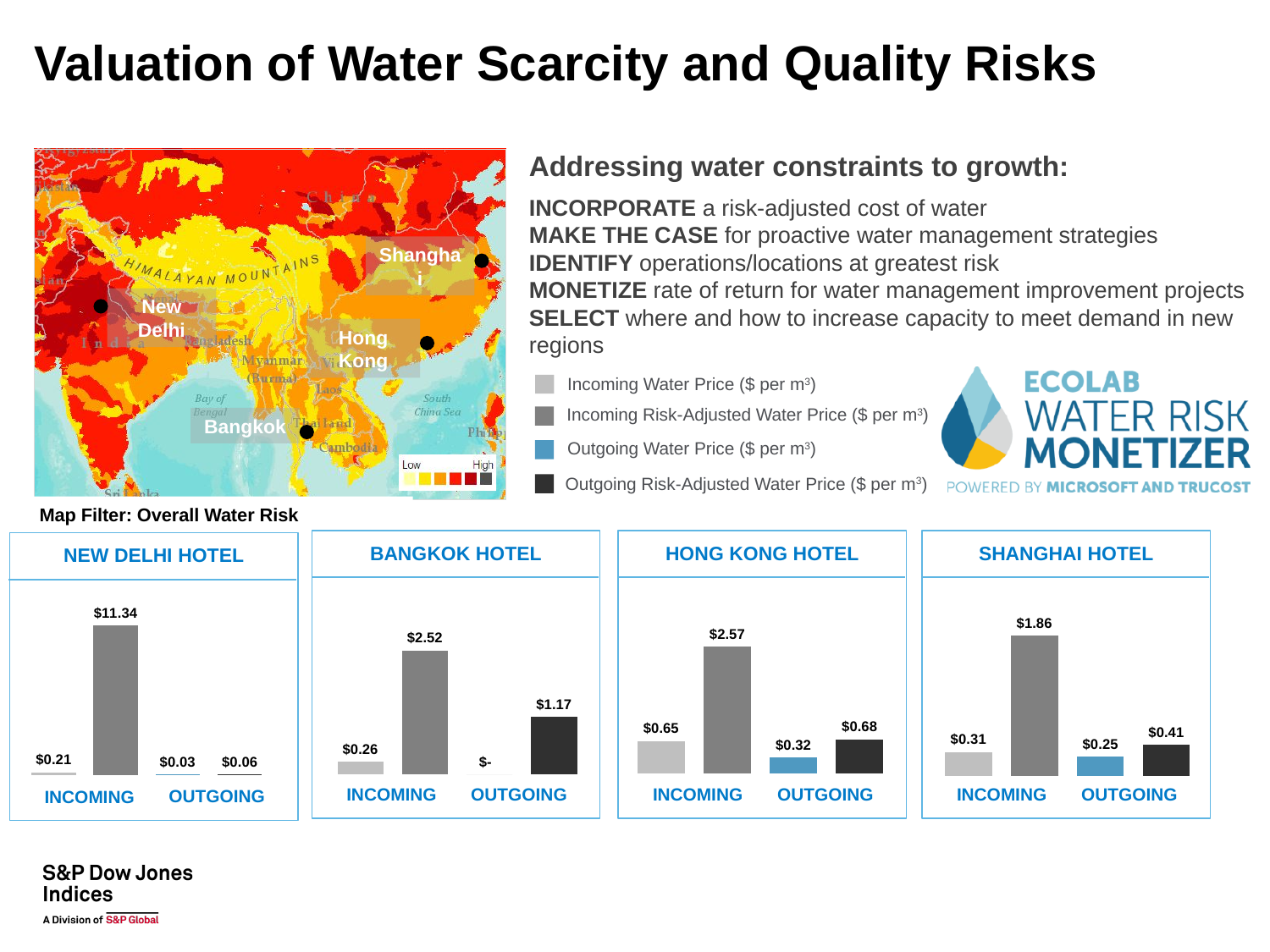
In the New Delhi Hotel chart, which bar is the lowest? Outgoing Water Price How many bars are plotted in the Bangkok Hotel chart? 4 In the Hong Kong Hotel chart, which bar is the highest? Incoming Risk-Adjusted Water Price In the Bangkok Hotel chart, what is the Outgoing Risk-Adjusted Water Price? $1.17 In the Hong Kong Hotel chart, what is the Incoming Water Price? $0.65 In the Shanghai Hotel chart, what is the difference between the Incoming Risk-Adjusted Water Price and the Incoming Water Price? $1.55 How many series does the shared legend list for the hotel charts? 4 In the New Delhi Hotel chart, what is the Incoming Risk-Adjusted Water Price? $11.34 Which is larger: the Incoming Risk-Adjusted Water Price for the Bangkok Hotel or for the Hong Kong Hotel? Hong Kong Hotel What type of chart is used for the Shanghai Hotel? Bar chart In the Hong Kong Hotel chart, what is the difference between the Outgoing Risk-Adjusted Water Price and the Outgoing Water Price? $0.36 In the Shanghai Hotel chart, what is the Outgoing Water Price? $0.25